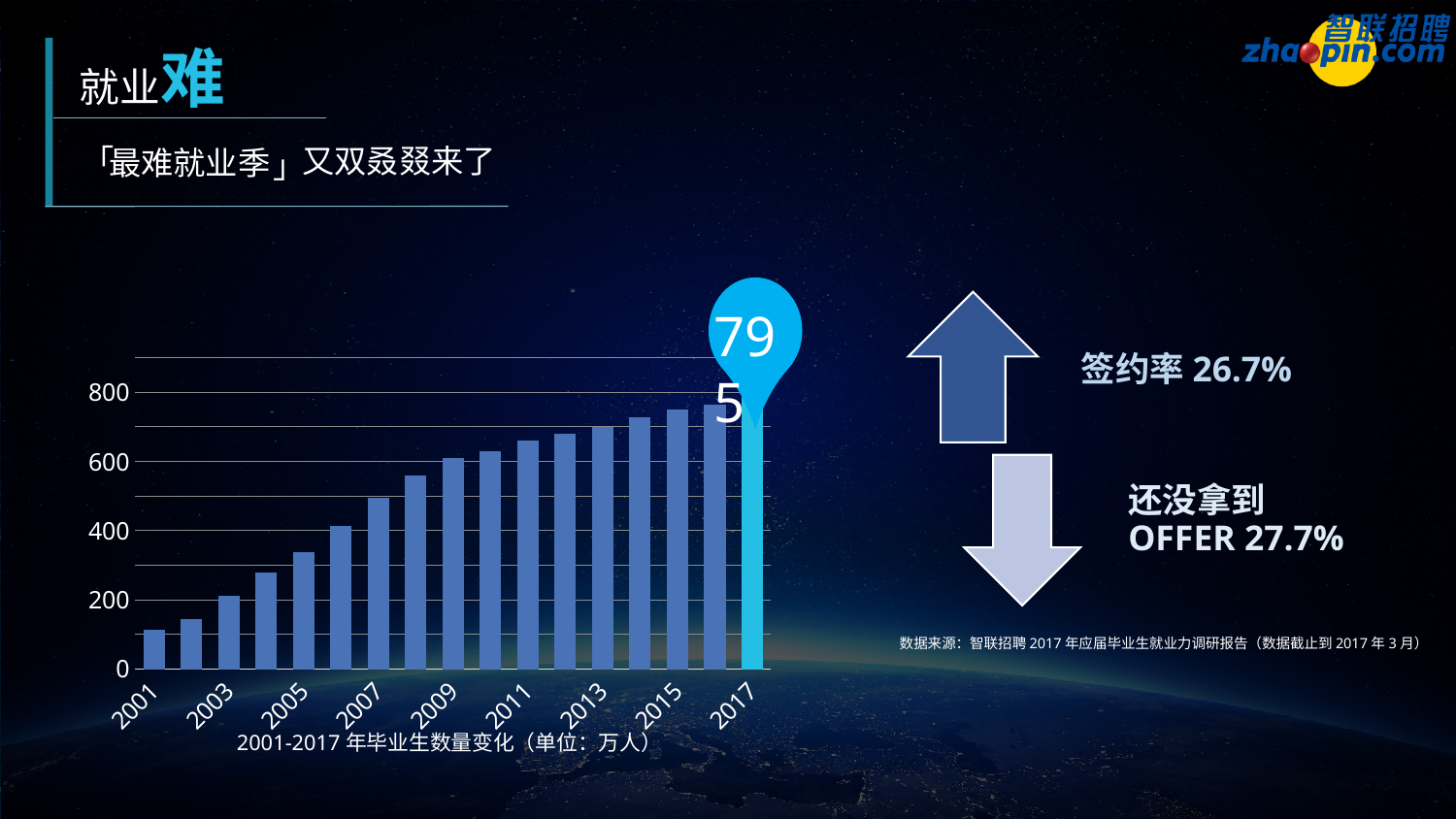
What kind of chart is shown on the slide? bar chart How many bars are plotted in the chart? 17 Is the value for 2005 greater or less than 400? less Which year has the lowest bar? 2001 Is the value for 2015 greater or less than 800? less Is the value for 2001 greater or less than 200? less What is the value labelled on the 2017 bar? 795 Which is larger, the value for 2009 or the value for 2005? 2009 Which year has the highest bar? 2017 Do the values rise or fall from 2001 to 2017? rise What is the title of the chart? 2001-2017 年毕业生数量变化（单位：万人）